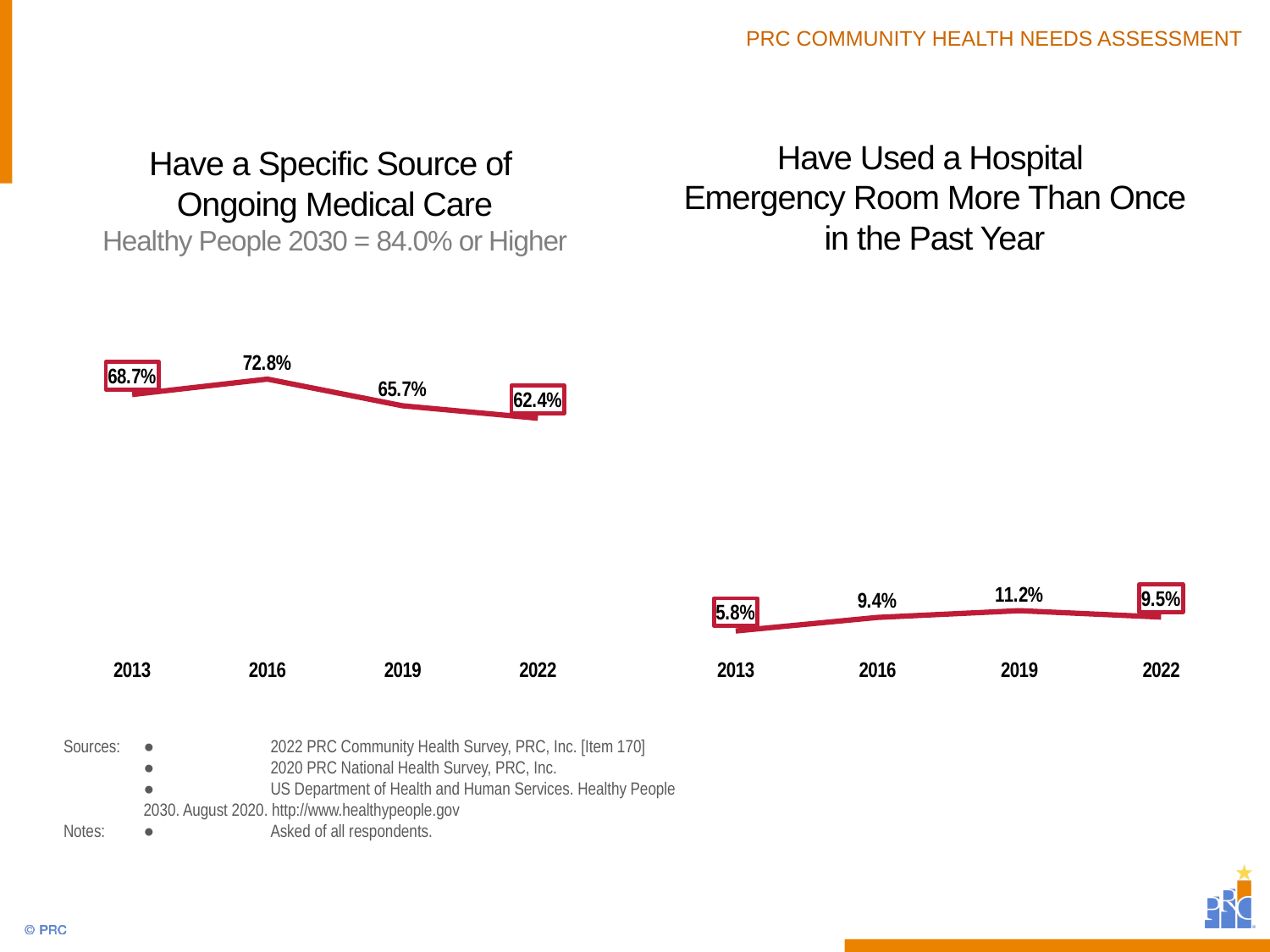
In the 'Have a Specific Source of Ongoing Medical Care' chart, what is the value for 2022? 62.4% In the 'Have a Specific Source of Ongoing Medical Care' chart, which year has the lowest value? 2022 How many years are plotted in the 'Have a Specific Source of Ongoing Medical Care' chart? 4 In the 'Have Used a Hospital Emergency Room More Than Once in the Past Year' chart, what is the value for 2019? 11.2% In the 'Have a Specific Source of Ongoing Medical Care' chart, what is the difference between the 2016 and 2022 values? 10.4 percentage points In the 'Have a Specific Source of Ongoing Medical Care' chart, which year has the highest value? 2016 In the 'Have a Specific Source of Ongoing Medical Care' chart, what is the value for 2016? 72.8% What type of chart is the 'Have Used a Hospital Emergency Room More Than Once in the Past Year' chart? Line chart In the 'Have Used a Hospital Emergency Room More Than Once in the Past Year' chart, what is the difference between the 2019 and 2013 values? 5.4 percentage points In the 'Have Used a Hospital Emergency Room More Than Once in the Past Year' chart, which is larger, the 2016 value or the 2022 value? 2022 In the 'Have Used a Hospital Emergency Room More Than Once in the Past Year' chart, what is the value for 2013? 5.8% In the 'Have Used a Hospital Emergency Room More Than Once in the Past Year' chart, which year has the highest value? 2019